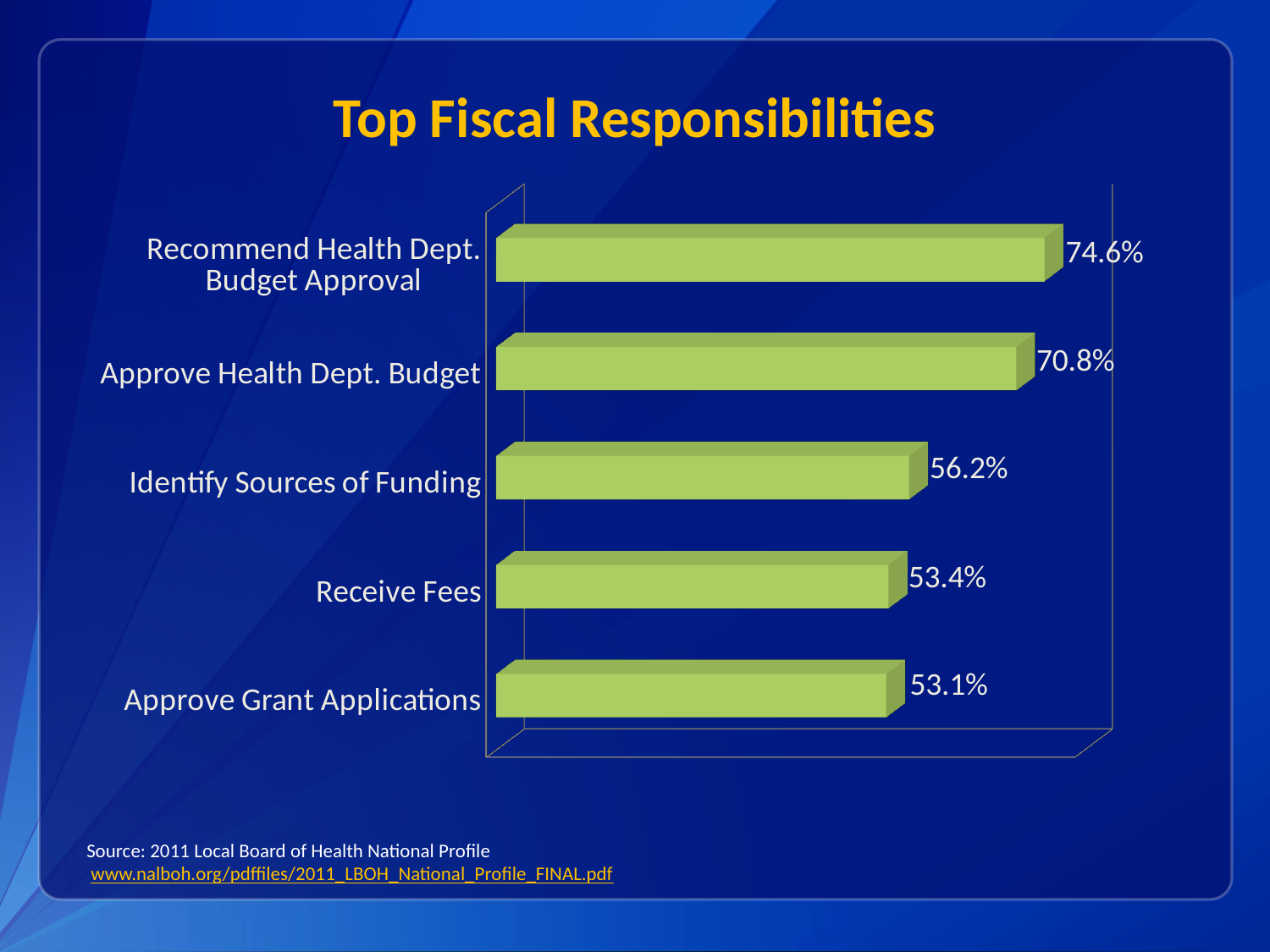
Which is larger, the value for Approve Health Dept. Budget or the value for Identify Sources of Funding? Approve Health Dept. Budget Which category has the lowest value? Approve Grant Applications What is the difference between the values for Recommend Health Dept. Budget Approval and Approve Health Dept. Budget? 3.8% How many categories are shown in the chart? 5 What is the value for Recommend Health Dept. Budget Approval? 74.6% What is the value for Approve Health Dept. Budget? 70.8% What is the difference between the values for Identify Sources of Funding and Receive Fees? 2.8% What is the value for Receive Fees? 53.4% What is the value for Approve Grant Applications? 53.1% Which category has the highest value? Recommend Health Dept. Budget Approval What is the value for Identify Sources of Funding? 56.2% What kind of chart is shown on the slide? Bar chart